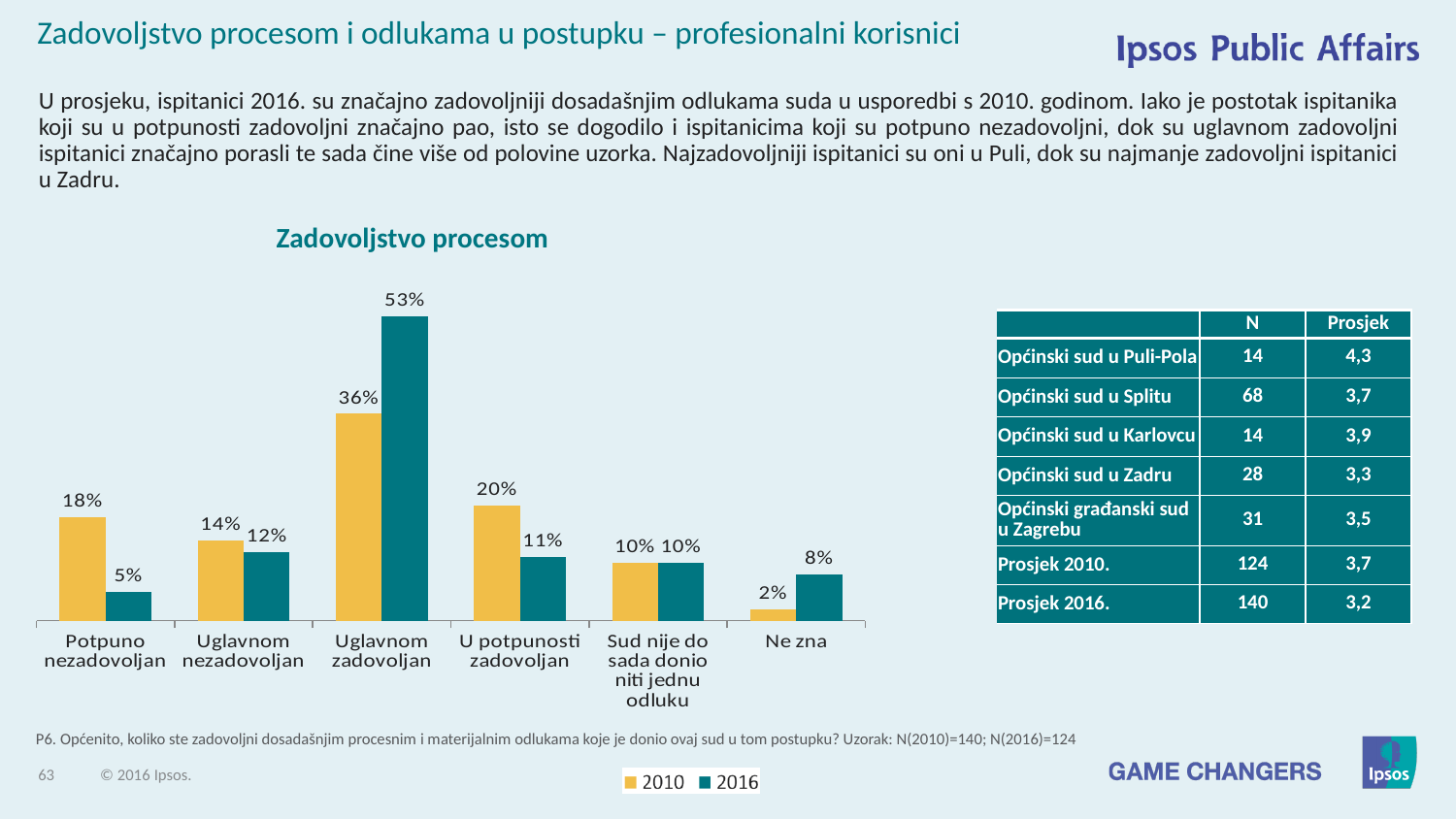
Which category has the highest 2016 value in the "Zadovoljstvo procesom" chart? Uglavnom zadovoljan What is the 2016 value for "Ne zna" in the "Zadovoljstvo procesom" chart? 8% Which series is shown in teal in the "Zadovoljstvo procesom" chart? 2016 In the "Zadovoljstvo procesom" chart, is the 2010 value for "U potpunosti zadovoljan" larger or smaller than the 2016 value? larger What is the difference between the 2016 and 2010 values for "Uglavnom zadovoljan" in the "Zadovoljstvo procesom" chart? 17% What is the 2016 value for "Uglavnom zadovoljan" in the "Zadovoljstvo procesom" chart? 53% How many series does the legend of the "Zadovoljstvo procesom" chart list? 2 What is the 2010 value for "Potpuno nezadovoljan" in the "Zadovoljstvo procesom" chart? 18% What is the difference between the 2010 and 2016 values for "Potpuno nezadovoljan" in the "Zadovoljstvo procesom" chart? 13% How many categories are shown on the x axis of the "Zadovoljstvo procesom" chart? 6 Which category has the lowest 2010 value in the "Zadovoljstvo procesom" chart? Ne zna What type of chart is "Zadovoljstvo procesom"? bar chart